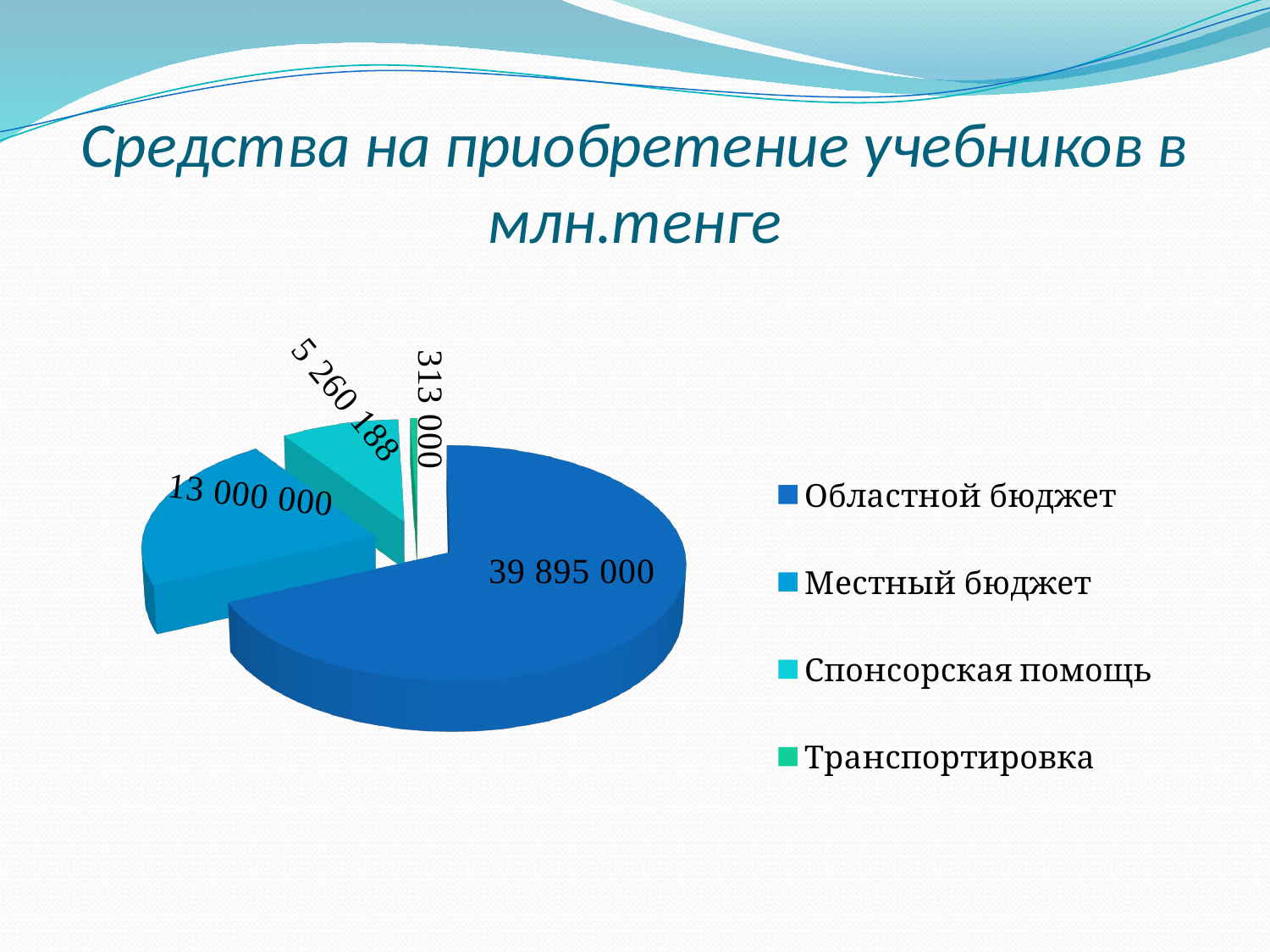
What is the value for Спонсорская помощь? 5 260 188 Which category has the largest slice of the pie? Областной бюджет What type of chart is shown on the slide? Pie chart What is the value for Местный бюджет? 13 000 000 What is the value for Транспортировка? 313 000 What is the difference between the values for Местный бюджет and Спонсорская помощь? 7 739 812 Which category has the smallest slice of the pie? Транспортировка Which is larger, Спонсорская помощь or Транспортировка? Спонсорская помощь What is the title of the chart on the slide? Средства на приобретение учебников в млн.тенге How many categories does the pie chart have? 4 What is the value for Областной бюджет? 39 895 000 What is the difference between the values for Областной бюджет and Местный бюджет? 26 895 000